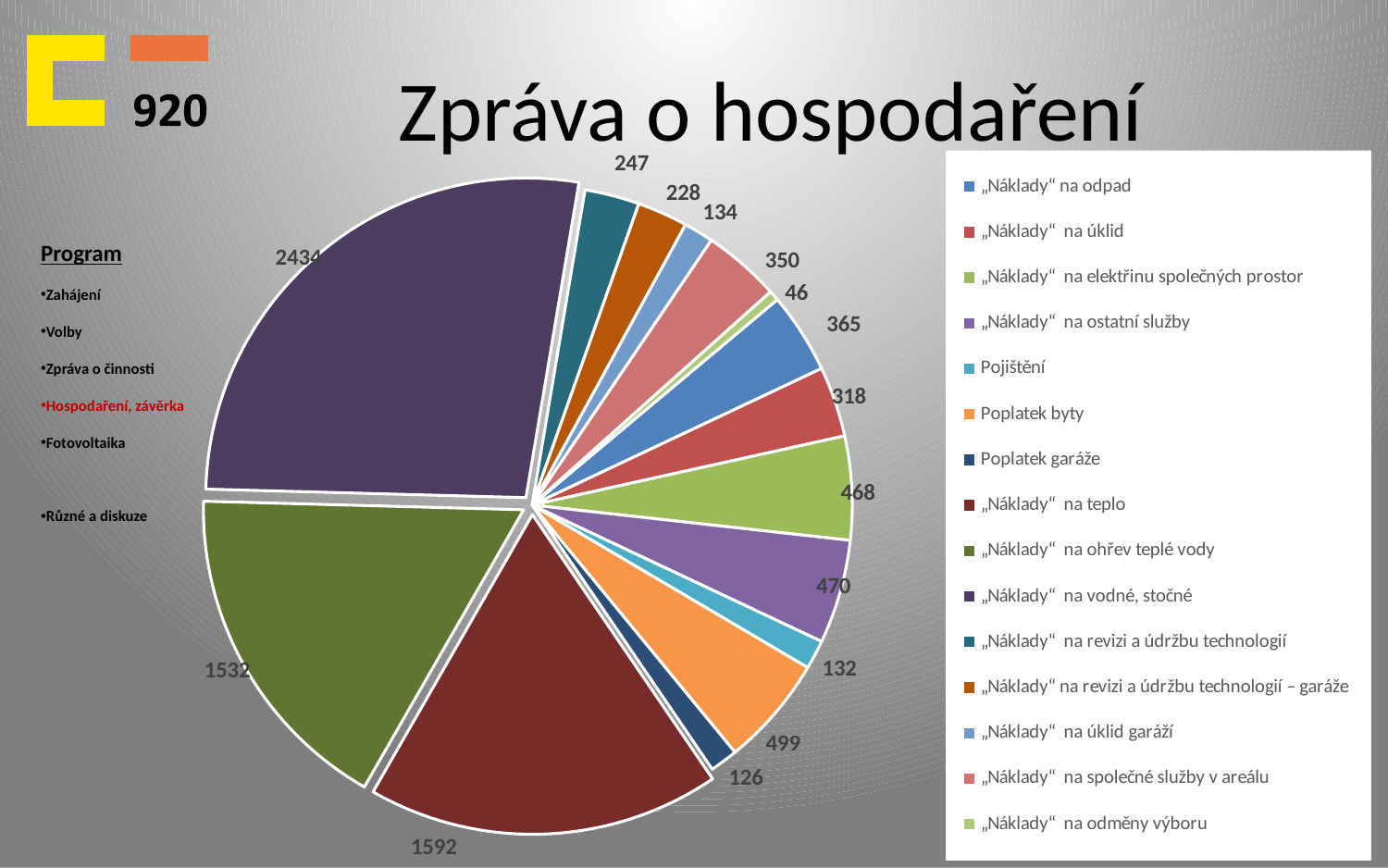
How many entries does the legend list? 15 What kind of chart is shown on the slide? pie chart Which category has the smallest slice in the pie chart? „Náklady“ na odměny výboru What is the value for „Náklady“ na ohřev teplé vody? 1532 What is the value for „Náklady“ na teplo? 1592 What is the difference between the values for „Náklady“ na teplo and „Náklady“ na ohřev teplé vody? 60 How many slices does the pie chart have? 15 Which category has the largest slice in the pie chart? „Náklady“ na vodné, stočné What is the value for Pojištění? 132 Which is larger, the value for „Náklady“ na odpad or the value for „Náklady“ na úklid? „Náklady“ na odpad What is the title of the chart slide? Zpráva o hospodaření What is the value for Poplatek byty? 499